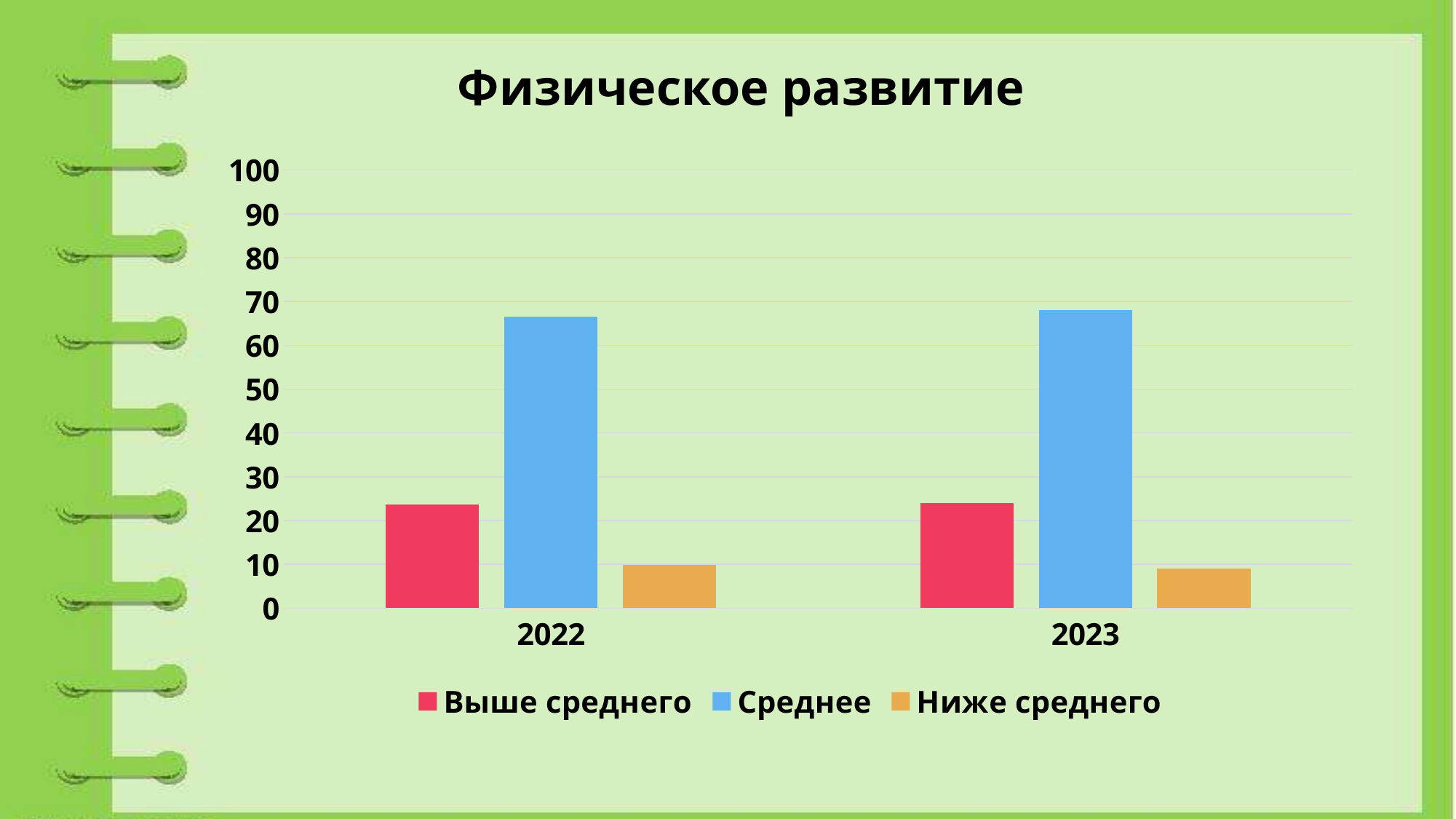
Which series has the lowest value in 2023? Ниже среднего In 2023, which is larger: Среднее or Выше среднего? Среднее How many categories are shown on the x axis? 2 What kind of chart is shown on the slide? bar chart Is the value for Выше среднего in 2022 greater or less than 30? less What is the title of the chart? Физическое развитие Which series has the highest value in 2022? Среднее How many series does the legend list? 3 Which colour represents the series Ниже среднего in the legend? orange Is the value for Среднее in 2023 greater or less than 70? less Is the value for Выше среднего in 2023 greater or less than 20? greater